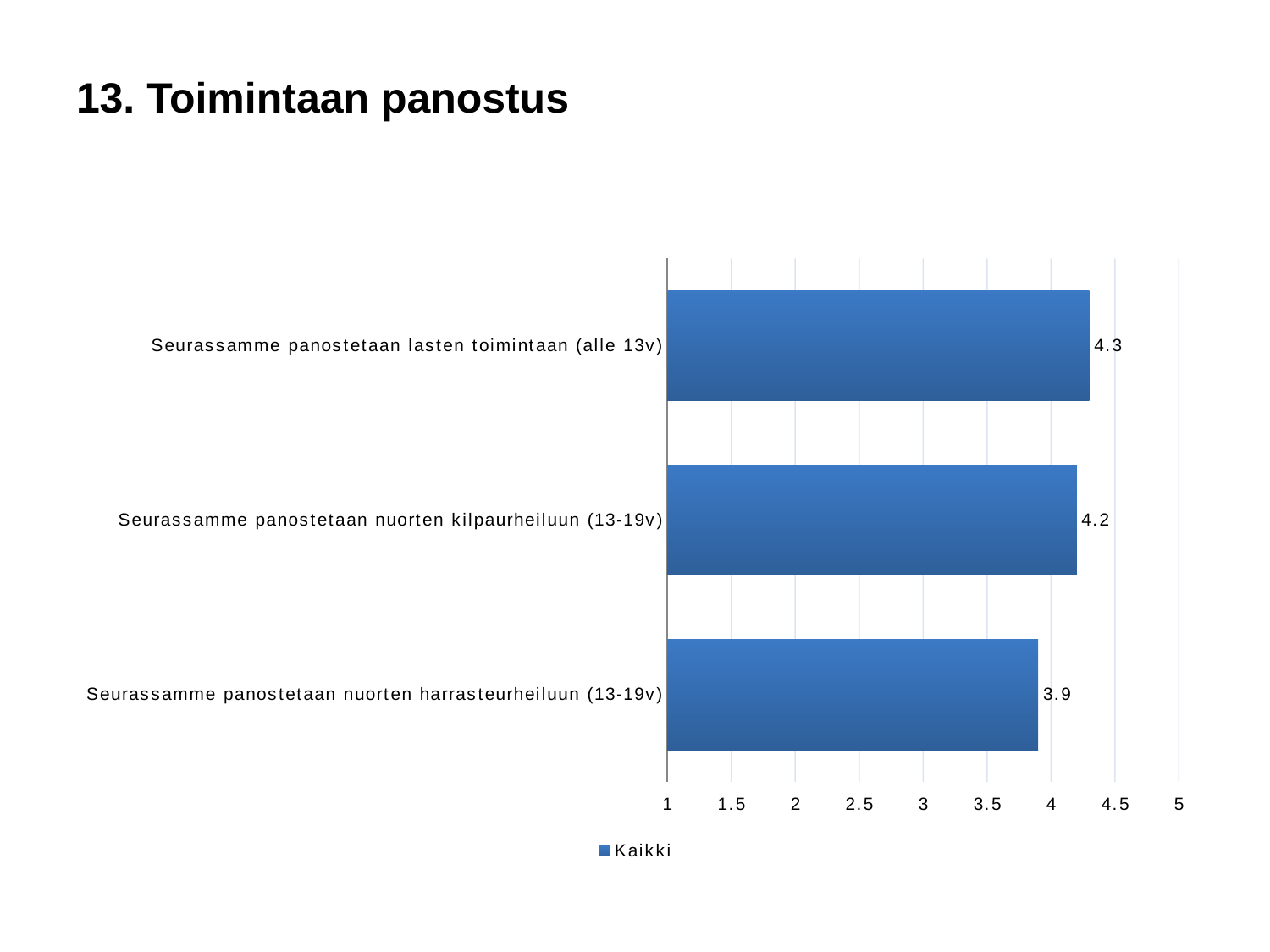
Which category has the highest value? Seurassamme panostetaan lasten toimintaan (alle 13v) How many series does the legend list? 1 What is the difference between the values for "Seurassamme panostetaan nuorten kilpaurheiluun (13-19v)" and "Seurassamme panostetaan nuorten harrasteurheiluun (13-19v)"? 0.3 Is the value for "Seurassamme panostetaan nuorten harrasteurheiluun (13-19v)" greater or less than 4? less What is the value for "Seurassamme panostetaan nuorten kilpaurheiluun (13-19v)"? 4.2 What is the value for "Seurassamme panostetaan lasten toimintaan (alle 13v)"? 4.3 What is the difference between the values for "Seurassamme panostetaan lasten toimintaan (alle 13v)" and "Seurassamme panostetaan nuorten harrasteurheiluun (13-19v)"? 0.4 What is the value for "Seurassamme panostetaan nuorten harrasteurheiluun (13-19v)"? 3.9 Which is larger: the value for "Seurassamme panostetaan nuorten kilpaurheiluun (13-19v)" or for "Seurassamme panostetaan nuorten harrasteurheiluun (13-19v)"? Seurassamme panostetaan nuorten kilpaurheiluun (13-19v) What kind of chart is shown on the slide? bar chart Which category has the lowest value? Seurassamme panostetaan nuorten harrasteurheiluun (13-19v) How many categories are shown in the chart? 3